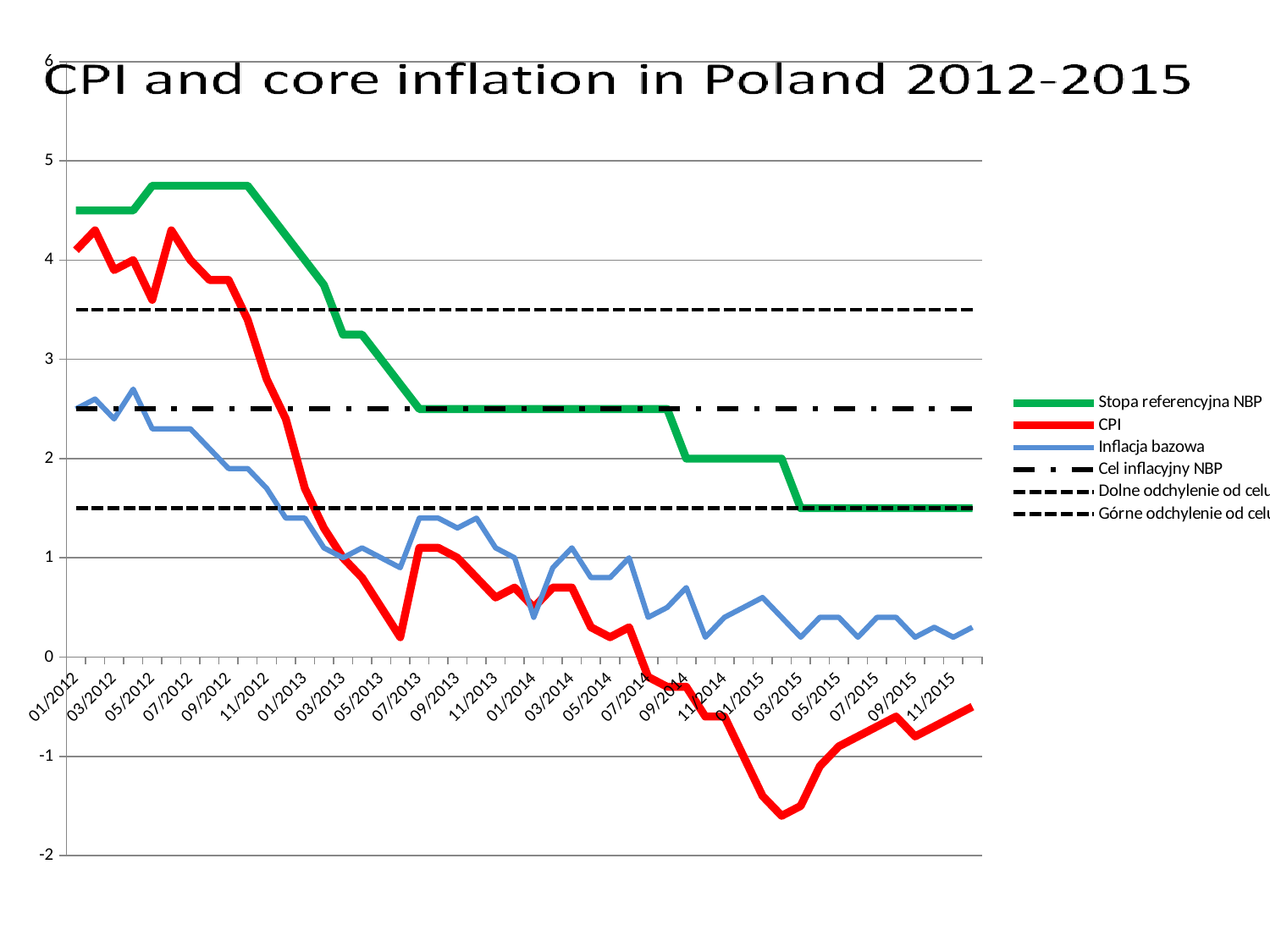
What is the title of the chart? CPI and core inflation in Poland 2012-2015 Is the value of CPI in 03/2015 greater or less than -1? less Does the Stopa referencyjna NBP series rise or fall from 01/2012 to 11/2015? fall Which series is drawn in green? Stopa referencyjna NBP How many series does the legend list? 6 Is the value of CPI in 01/2012 greater or less than 4? greater In 11/2015, which is higher, CPI or Inflacja bazowa? Inflacja bazowa In 01/2012, which is higher, CPI or Inflacja bazowa? CPI What kind of chart is shown on the slide? line chart Is the value of Inflacja bazowa in 11/2015 greater or less than 1? less